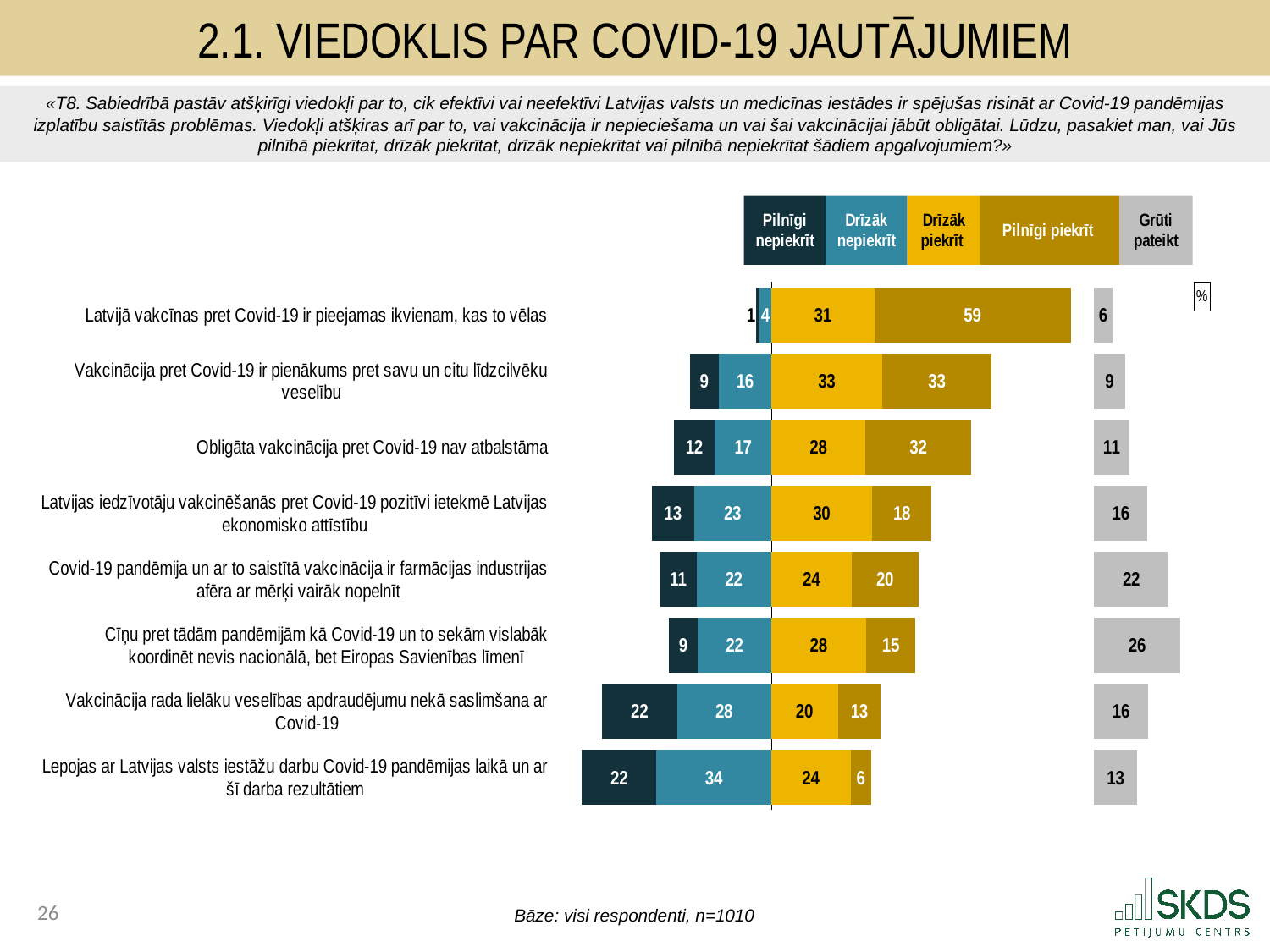
What is the combined share of 'Drīzāk piekrīt' and 'Pilnīgi piekrīt' for the statement 'Vakcinācija pret Covid-19 ir pienākums pret savu un citu līdzcilvēku veselību'? 66 What percentage of respondents fully agree (Pilnīgi piekrīt) that vaccines against Covid-19 in Latvia are available to everyone who wants them? 59 For the statement 'Vakcinācija rada lielāku veselības apdraudējumu nekā saslimšana ar Covid-19', which is larger: 'Pilnīgi nepiekrīt' or 'Drīzāk nepiekrīt'? Drīzāk nepiekrīt What is the difference between the 'Drīzāk piekrīt' and 'Pilnīgi piekrīt' values for the statement 'Obligāta vakcinācija pret Covid-19 nav atbalstāma'? 4 Which legend category is shown in grey? Grūti pateikt Which statement has the lowest 'Pilnīgi piekrīt' value? Lepojas ar Latvijas valsts iestāžu darbu Covid-19 pandēmijas laikā un ar šī darba rezultātiem What type of chart is shown on the slide? Stacked bar chart How many statements are shown in the chart? 8 What is the 'Grūti pateikt' value for the statement 'Cīņu pret tādām pandēmijām kā Covid-19 un to sekām vislabāk koordinēt nevis nacionālā, bet Eiropas Savienības līmenī'? 26 Which statement has the highest 'Pilnīgi piekrīt' value? Latvijā vakcīnas pret Covid-19 ir pieejamas ikvienam, kas to vēlas What is the 'Drīzāk nepiekrīt' value for the statement 'Lepojas ar Latvijas valsts iestāžu darbu Covid-19 pandēmijas laikā un ar šī darba rezultātiem'? 34 How many response categories does the legend list? 5